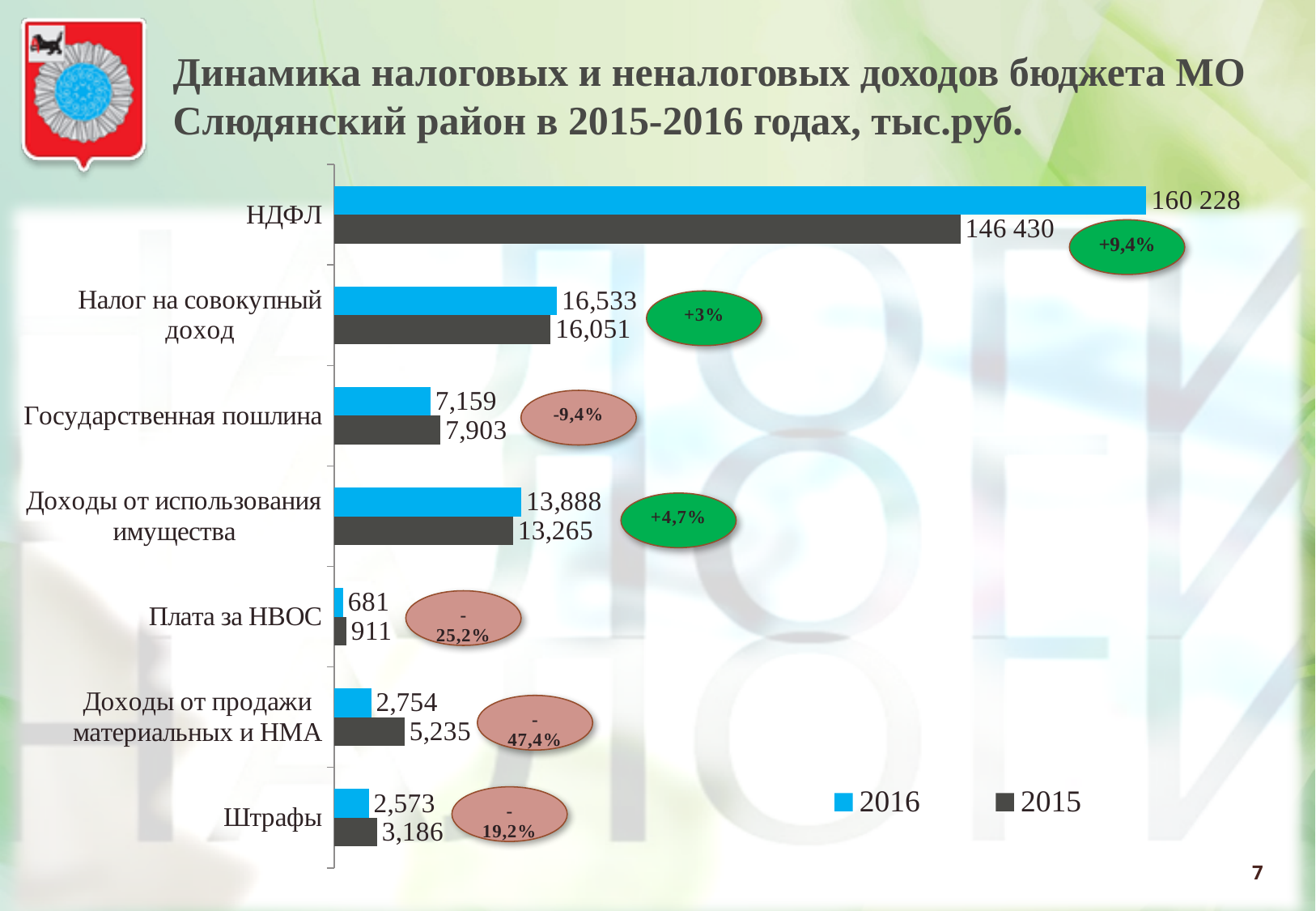
What is the 2016 value for НДФЛ? 160 228 Which colour represents the 2016 series in the legend? Blue How many categories are shown on the chart? 7 Which category has the highest 2016 value? НДФЛ Which category has the lowest 2015 value? Плата за НВОС For Государственная пошлина, which year has the larger value, 2015 or 2016? 2015 What is the difference between the 2015 and 2016 values for Штрафы? 613 What type of chart is shown on the slide? Bar chart What is the 2015 value for Налог на совокупный доход? 16,051 What is the 2016 value for Плата за НВОС? 681 How many series does the legend list? 2 What is the 2015 value for Доходы от продажи материальных и НМА? 5,235